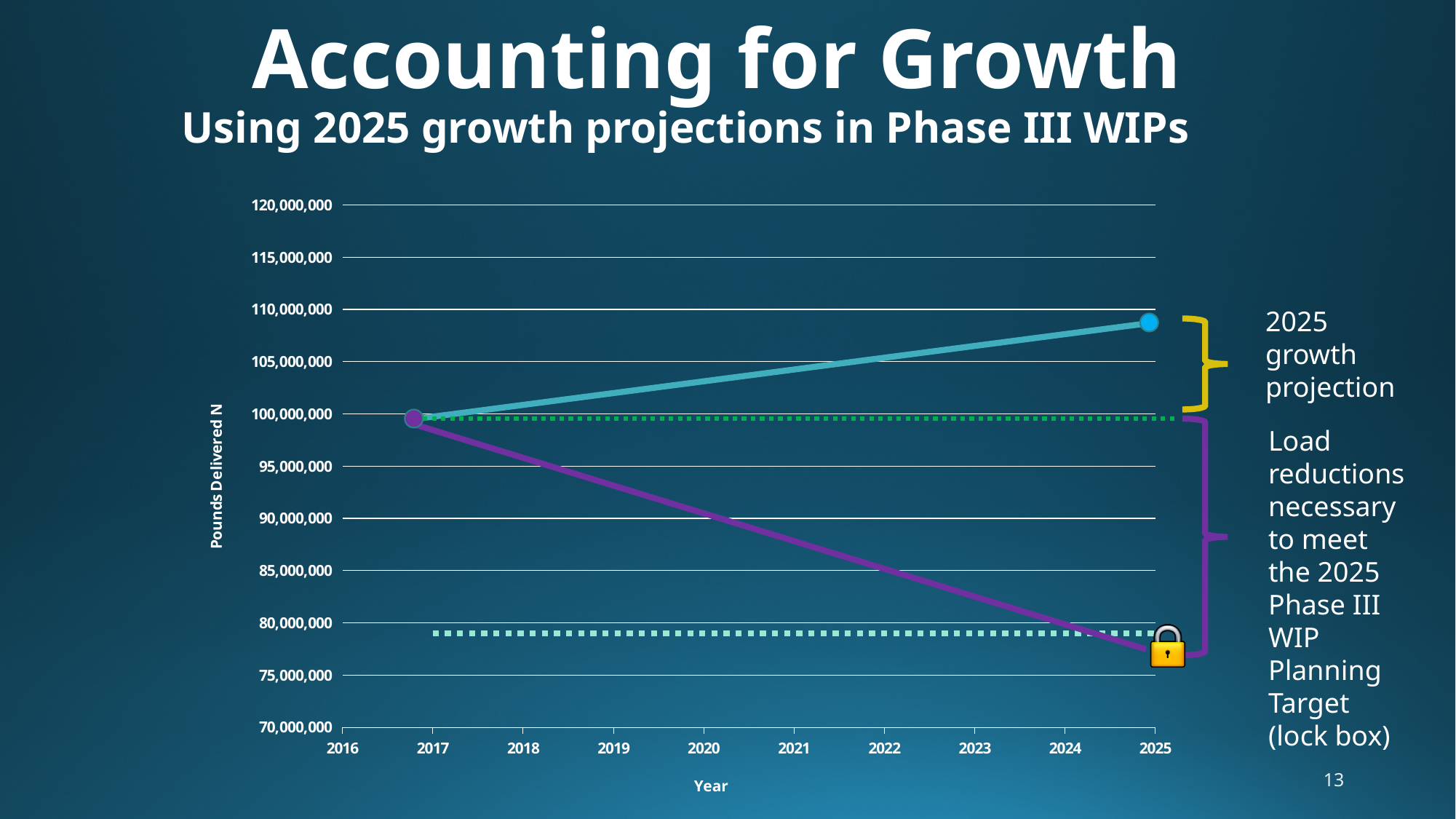
Is the value of the blue line in 2025 greater or less than 110,000,000? less Does the blue line rise or fall from 2017 to 2025? rise How many year labels are shown on the x axis of the chart? 10 In 2025, which line has the higher value, the blue line or the purple line? the blue line Is the value of the purple line in 2025 greater or less than 75,000,000? greater Is the value of the purple line in 2025 greater or less than 80,000,000? less What is the label on the vertical axis of the chart? Pounds Delivered N What is the first year labelled on the x axis? 2016 Does the purple line rise or fall from 2017 to 2025? fall What kind of chart is shown on the slide? line chart